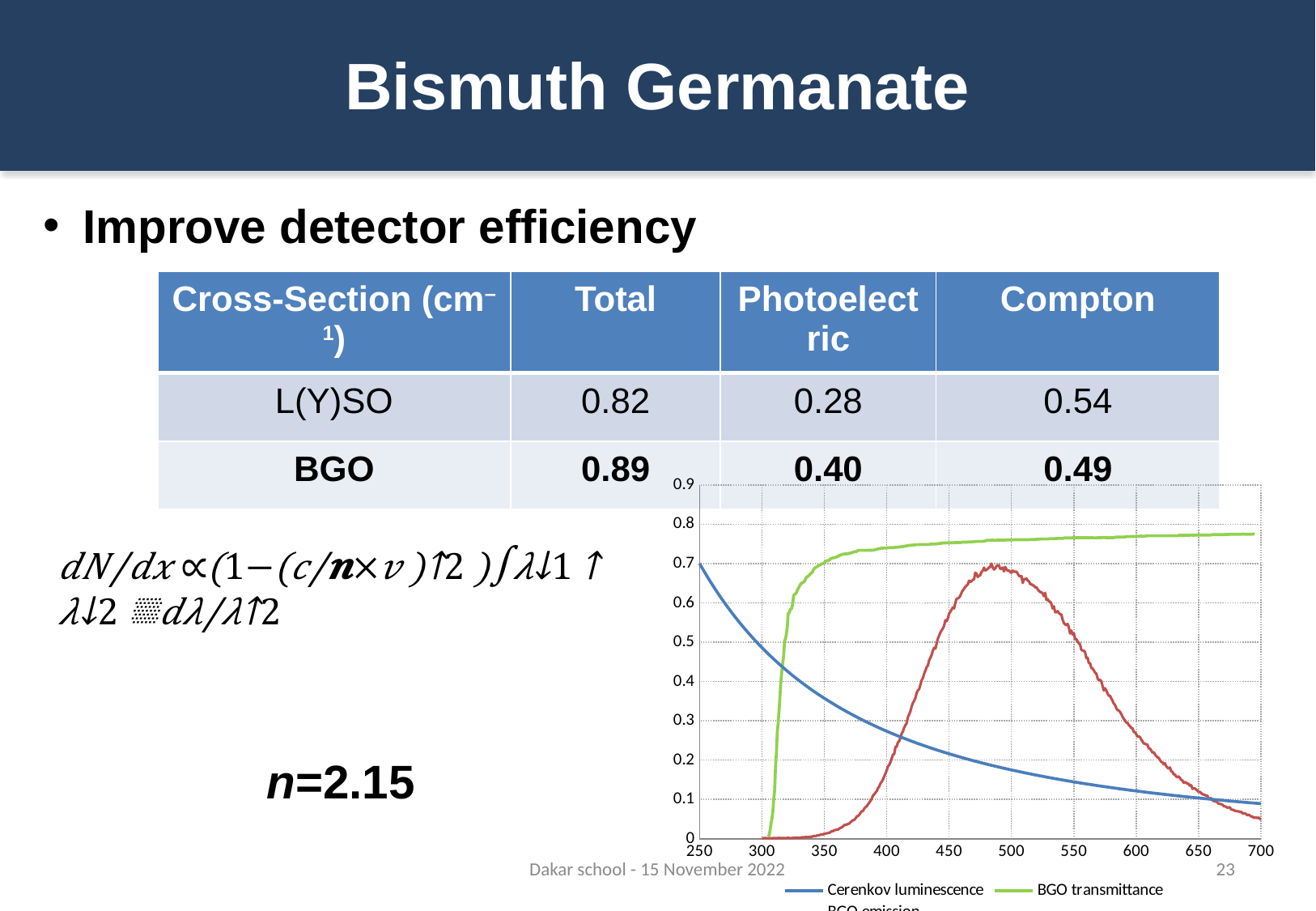
Is the value of Cerenkov luminescence at x = 250 greater or less than 0.6? greater Does the Cerenkov luminescence line rise or fall as the x axis increases from 250 to 700? fall At x = 600, which is higher: BGO transmittance or Cerenkov luminescence? BGO transmittance Is the value of BGO transmittance at x = 700 greater or less than 0.7? greater What colour is the Cerenkov luminescence line? blue Does the BGO transmittance line rise or fall as the x axis increases from 300 to 700? rise What kind of chart is shown on the slide? line chart Is the value of BGO transmittance at x = 300 greater or less than 0.1? less How many lines are plotted on the chart? 3 Which series has the highest value at x = 700? BGO transmittance At x = 400, which is higher: Cerenkov luminescence or the red line? Cerenkov luminescence